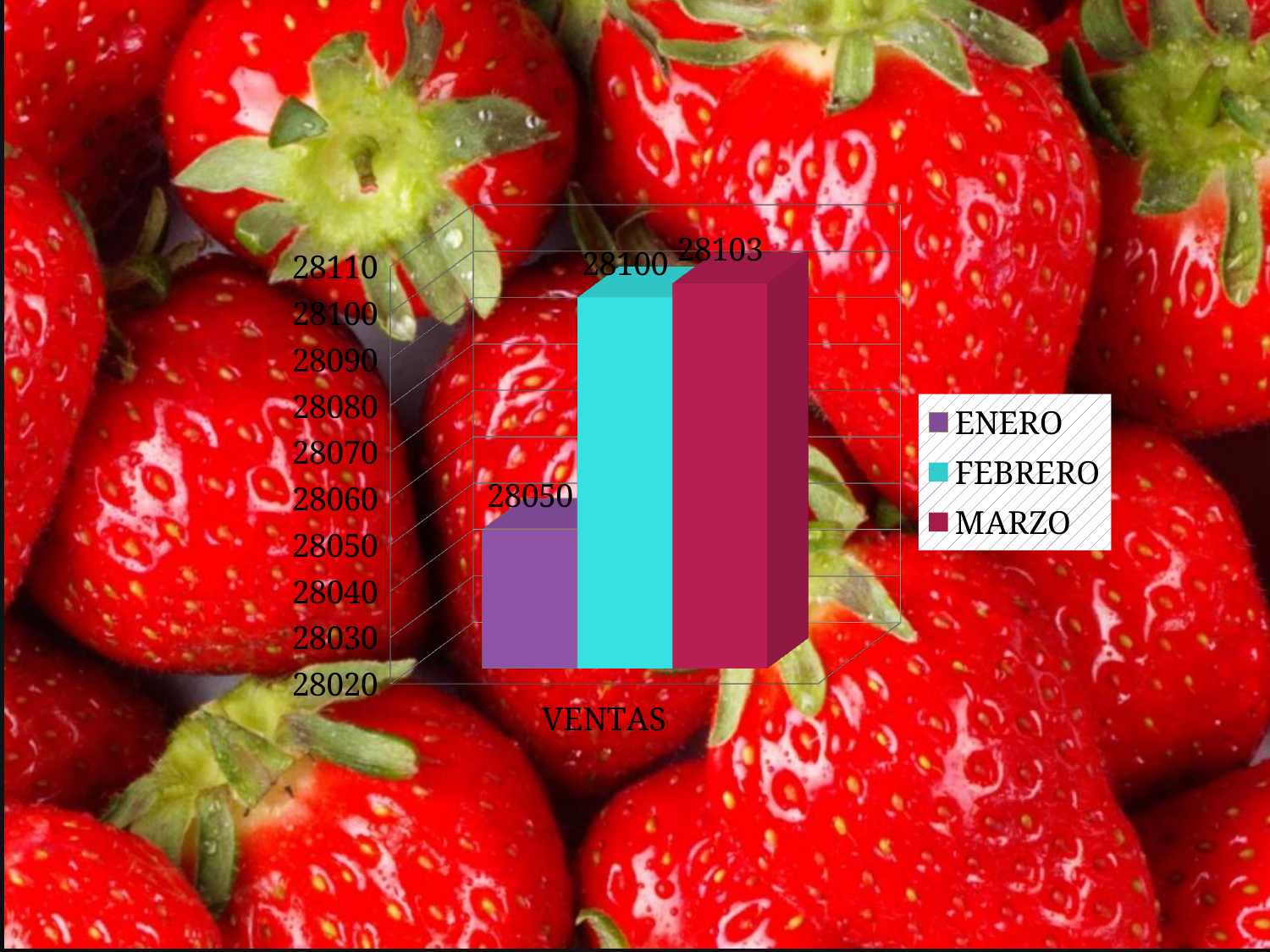
What is the value for ENERO? 28050 What is the category label shown on the x axis? VENTAS What is the difference between the values for FEBRERO and ENERO? 50 What is the difference between the values for MARZO and FEBRERO? 3 Which series has the highest value? MARZO How many series does the legend list? 3 Is the value for ENERO greater or less than 28060? less What kind of chart is shown on the slide? bar chart Which is larger, the value for ENERO or the value for FEBRERO? FEBRERO What is the value for FEBRERO? 28100 Which series has the lowest value? ENERO What is the value for MARZO? 28103